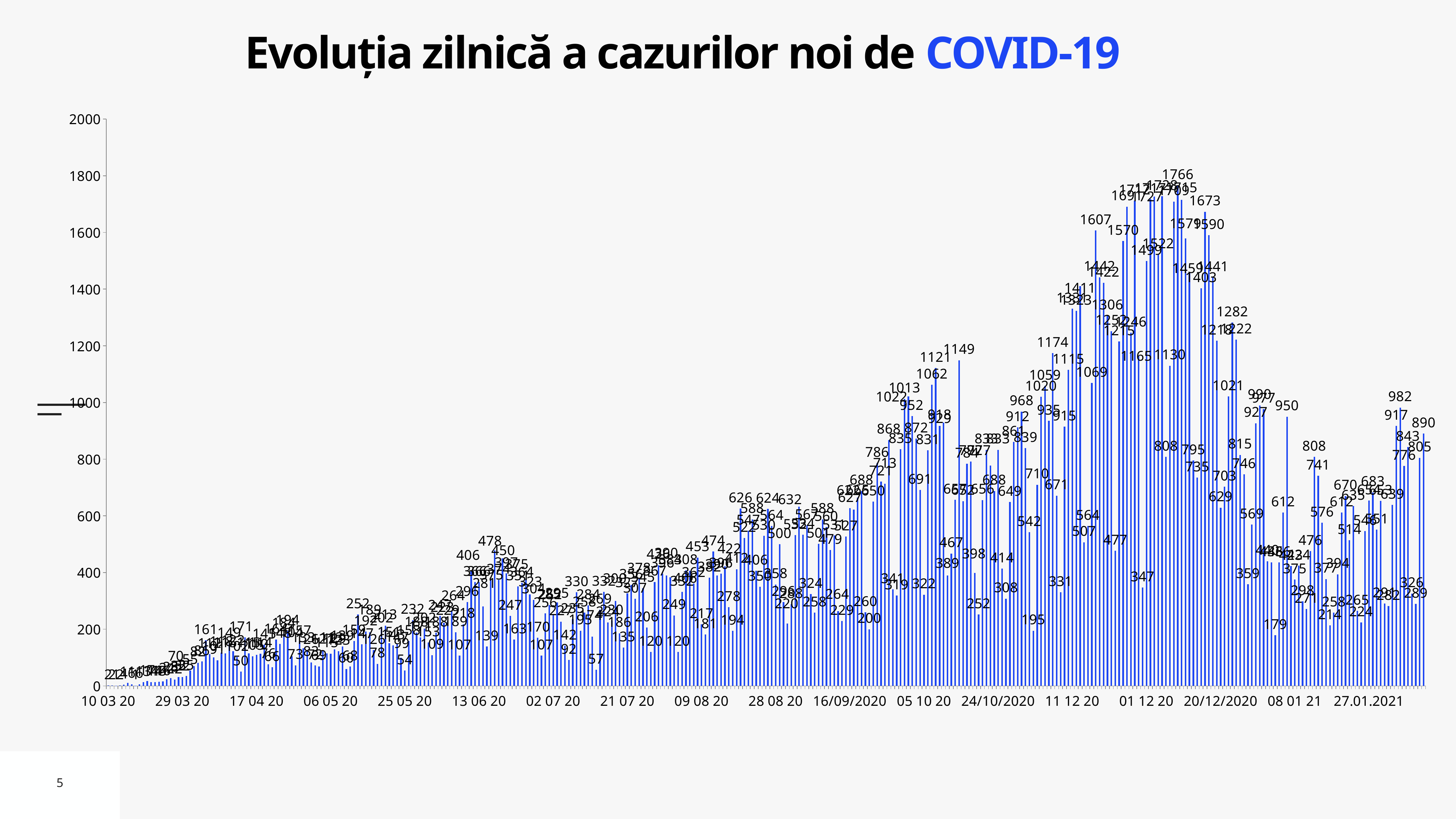
What is the highest daily value labelled on the chart? 1766 What is the difference between the bars labelled 982 and 890 near the right end of the chart? 92 Do the daily values generally rise or fall from 10 03 20 to 01 12 20? rise What is the difference between the bars labelled 1766 and 1673? 93 What is the value of the rightmost (last) bar on the chart? 890 Is the peak value on the chart greater or less than 1600? greater What is the title of the chart? Evoluția zilnică a cazurilor noi de COVID-19 Is the value of the last bar on the right greater or less than 1000? less Which is larger, the bar labelled 1766 or the bar labelled 1673? 1766 What is the highest tick value shown on the vertical axis? 2000 How many tick labels are shown on the vertical axis? 11 What kind of chart is shown on the slide? bar chart